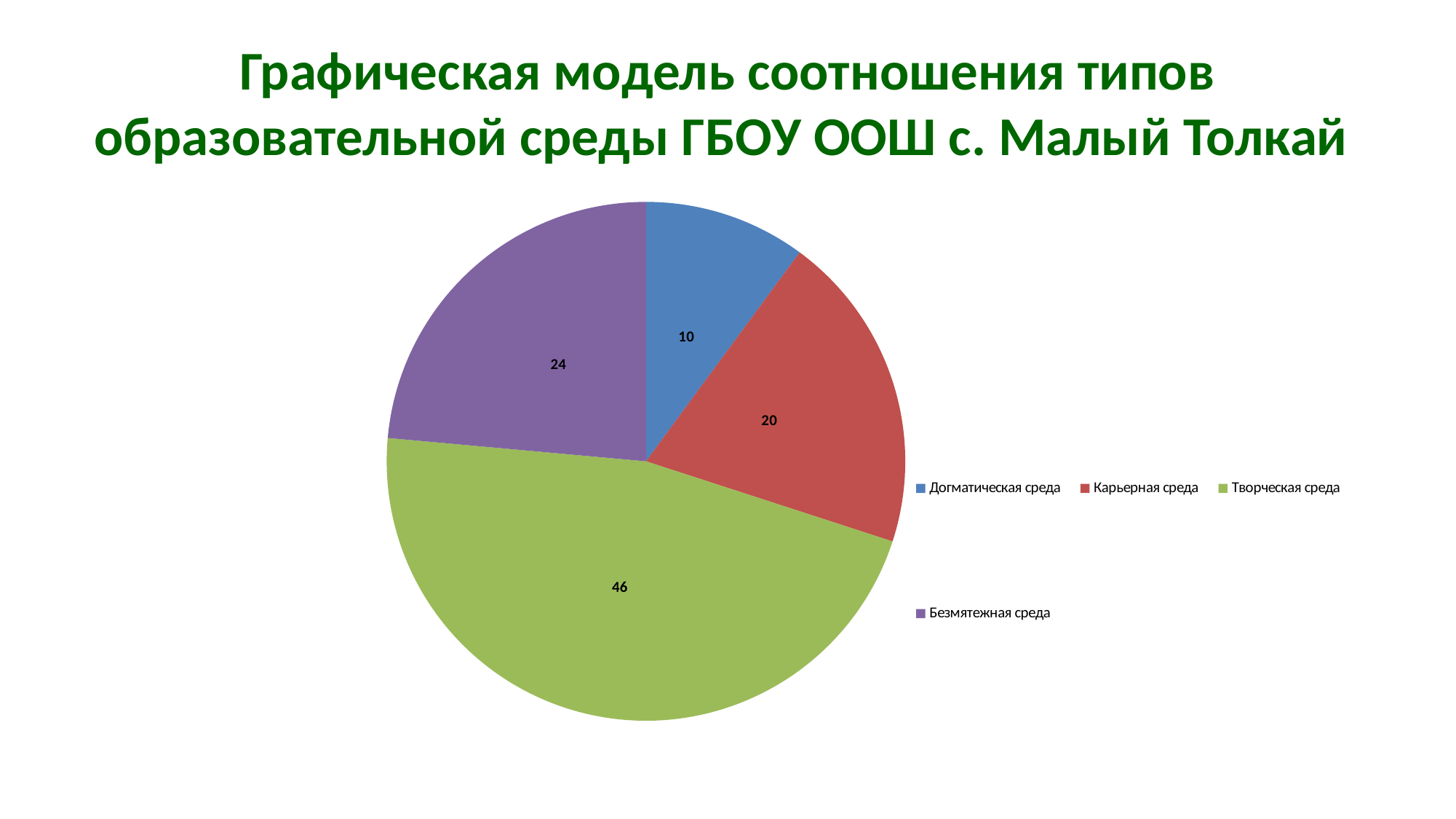
What is the difference between the values for Творческая среда and Безмятежная среда? 22 What is the value for Творческая среда? 46 What is the value for Догматическая среда? 10 Which category has the largest slice? Творческая среда What is the value for Карьерная среда? 20 How many slices does the pie chart have? 4 What colour is the slice for Безмятежная среда? Purple Which is larger, the value for Безмятежная среда or the value for Карьерная среда? Безмятежная среда What share of the pie does Творческая среда represent? 46% Which category has the smallest slice? Догматическая среда What kind of chart is shown on the slide? Pie chart What is the value for Безмятежная среда? 24